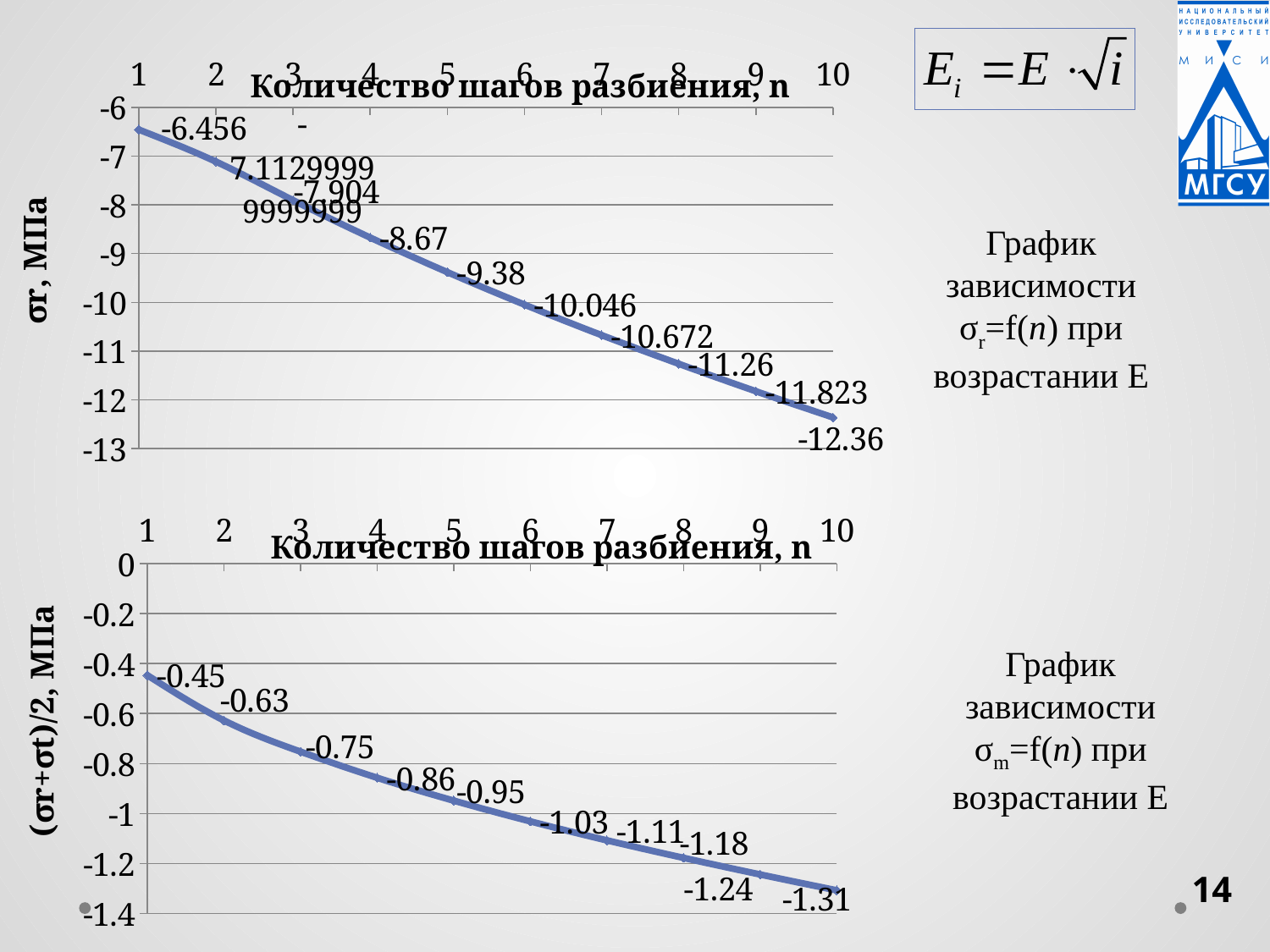
In the top chart, what is the difference between the values at n = 1 and n = 10? 5.904 In the top chart, what is the value of σr at n = 1? -6.456 In the bottom chart, what is the difference between the values at n = 1 and n = 10? 0.86 In the bottom chart, what is the value at n = 1? -0.45 What type of chart is the bottom chart? line chart In the top chart, what is the value of σr at n = 10? -12.36 In the top chart, how many data points are plotted? 10 In the bottom chart, what is the value at n = 10? -1.31 In the top chart, what is the value of σr at n = 5? -9.38 In the bottom chart, what is the value at n = 6? -1.03 In the top chart, do the values rise or fall as n increases from 1 to 10? fall What is the y-axis label of the bottom chart? (σr+σt)/2, МПа